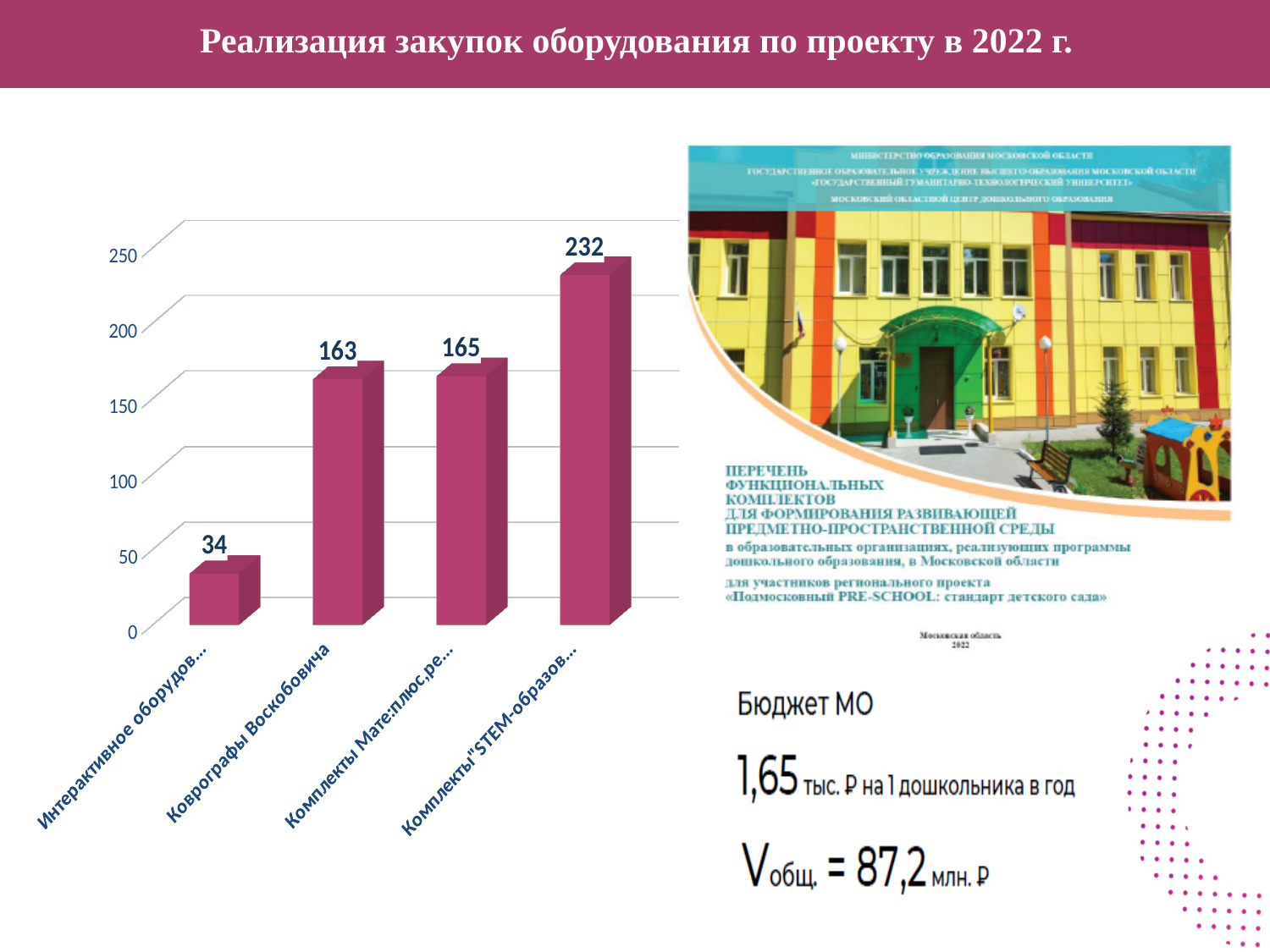
What is the difference between the values for Коврографы Воскобовича and Интерактивное оборудов...? 129 How many categories are shown in the bar chart? 4 Which category has the highest value? Комплекты"STEM-образов... What kind of chart is shown on the slide? Bar chart What is the highest value shown on the vertical axis of the chart? 250 What value is shown for Коврографы Воскобовича? 163 What value is shown for the bar labelled Комплекты"STEM-образов...? 232 What value is shown for the bar labelled Комплекты Мате:плюс,ре...? 165 What value is shown for the bar labelled Интерактивное оборудов...? 34 Which category has the lowest value? Интерактивное оборудов... What is the difference between the values for Комплекты"STEM-образов... and Коврографы Воскобовича? 69 Which is larger: the value for Коврографы Воскобовича or the value for Интерактивное оборудов...? Коврографы Воскобовича